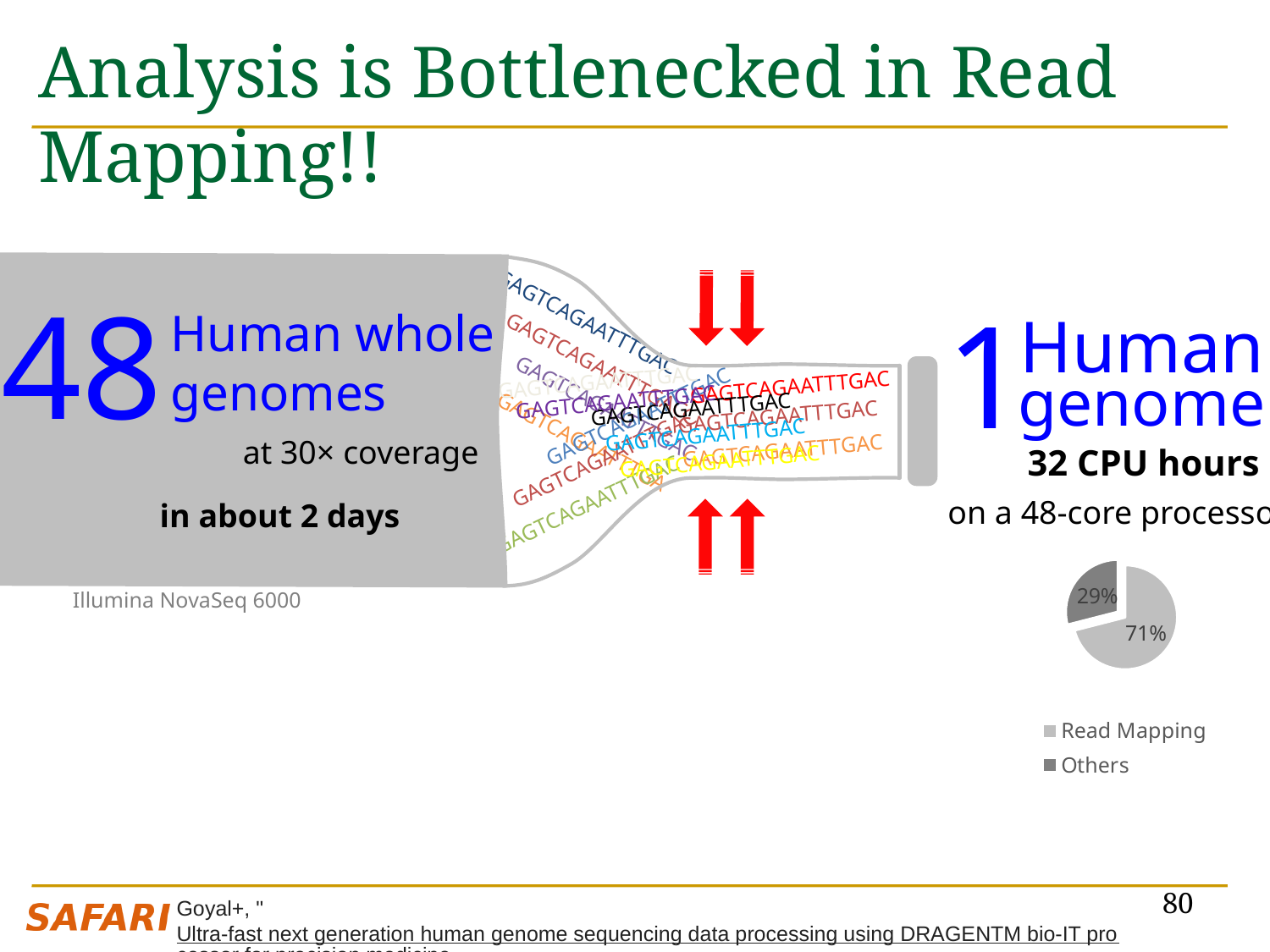
What share of the pie chart is labelled Read Mapping? 71% Which slice of the pie chart is the smallest? Others How many slices does the pie chart have? 2 What are the two legend entries of the pie chart? Read Mapping, Others What kind of chart is shown on the slide? pie chart Which slice of the pie chart is the largest? Read Mapping How many entries does the pie chart's legend list? 2 What is the difference in percentage points between the Read Mapping slice and the Others slice? 42 Is the Read Mapping share of the pie chart greater or less than 50%? greater Which is larger in the pie chart, Read Mapping or Others? Read Mapping What share of the pie chart is labelled Others? 29%